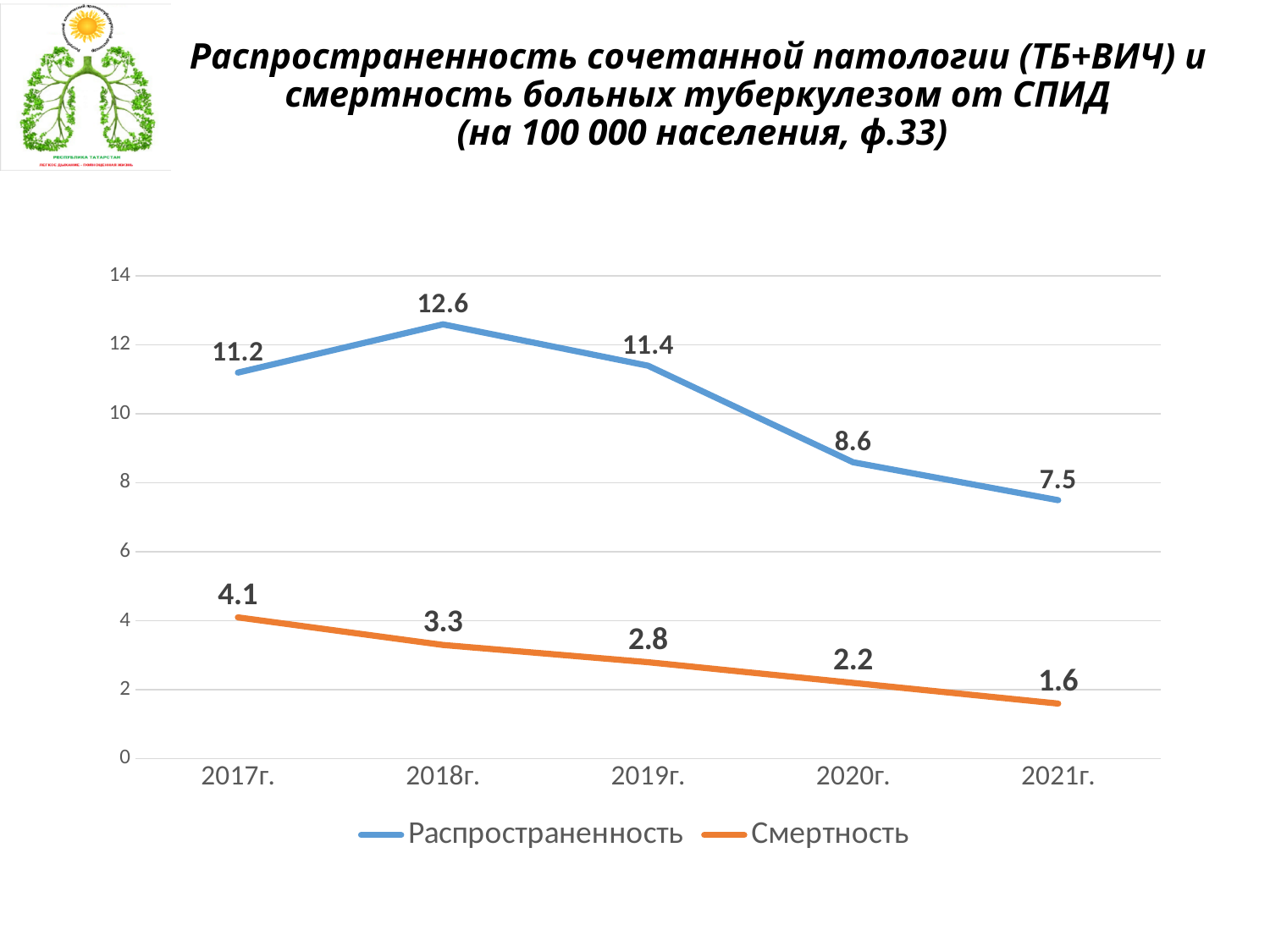
What is the value of Смертность in 2020г.? 2.2 What is the value of Распространенность in 2021г.? 7.5 How many years are shown on the x axis? 5 How many series does the legend list? 2 In which year is Смертность lowest? 2021г. What is the difference between Распространенность and Смертность in 2017г.? 7.1 In which year is Распространенность highest? 2018г. Which is larger: Распространенность in 2019г. or Распространенность in 2020г.? 2019г. What kind of chart is shown on the slide? line chart What is the value of Распространенность in 2018г.? 12.6 Does Смертность rise or fall from 2017г. to 2021г.? fall By how much did Смертность decrease from 2017г. to 2021г.? 2.5